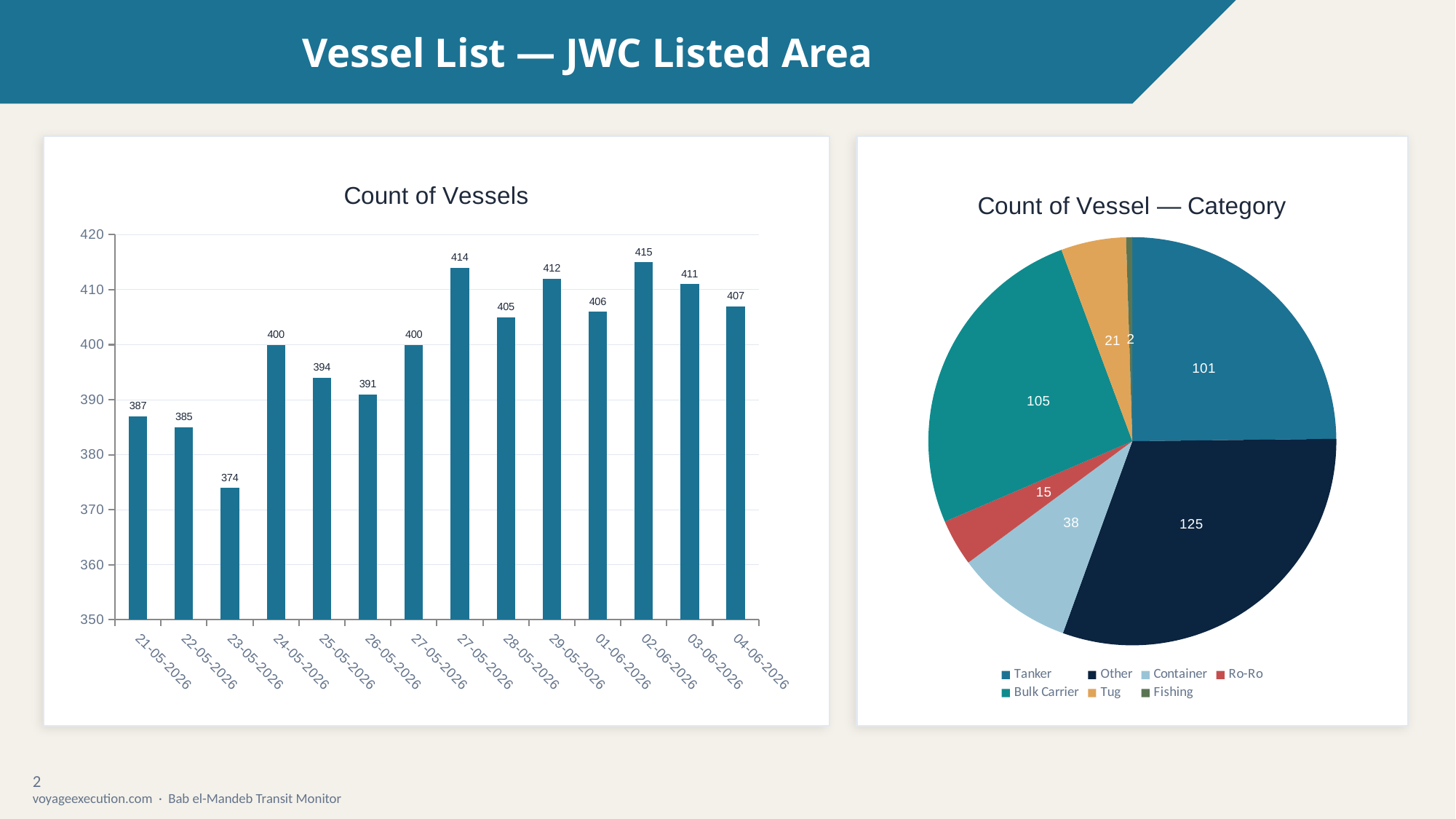
In the 'Count of Vessel — Category' pie chart, which category has the largest slice? Other In the 'Count of Vessel — Category' pie chart, what is the value for Bulk Carrier? 105 In the 'Count of Vessels' bar chart, which is larger: the value for 25-05-2026 or the value for 28-05-2026? 28-05-2026 How many categories does the legend of the 'Count of Vessel — Category' pie chart list? 7 In the 'Count of Vessels' bar chart, what is the difference between the values for 04-06-2026 and 21-05-2026? 20 In the 'Count of Vessels' bar chart, what is the value for 02-06-2026? 415 In the 'Count of Vessels' bar chart, which date has the lowest count? 23-05-2026 In the 'Count of Vessels' bar chart, how many bars are plotted? 14 What kind of chart is the 'Count of Vessels' chart? Bar chart In the 'Count of Vessels' bar chart, which date has the highest count? 02-06-2026 In the 'Count of Vessel — Category' pie chart, which category has the smallest slice? Fishing In the 'Count of Vessels' bar chart, what is the value for 23-05-2026? 374